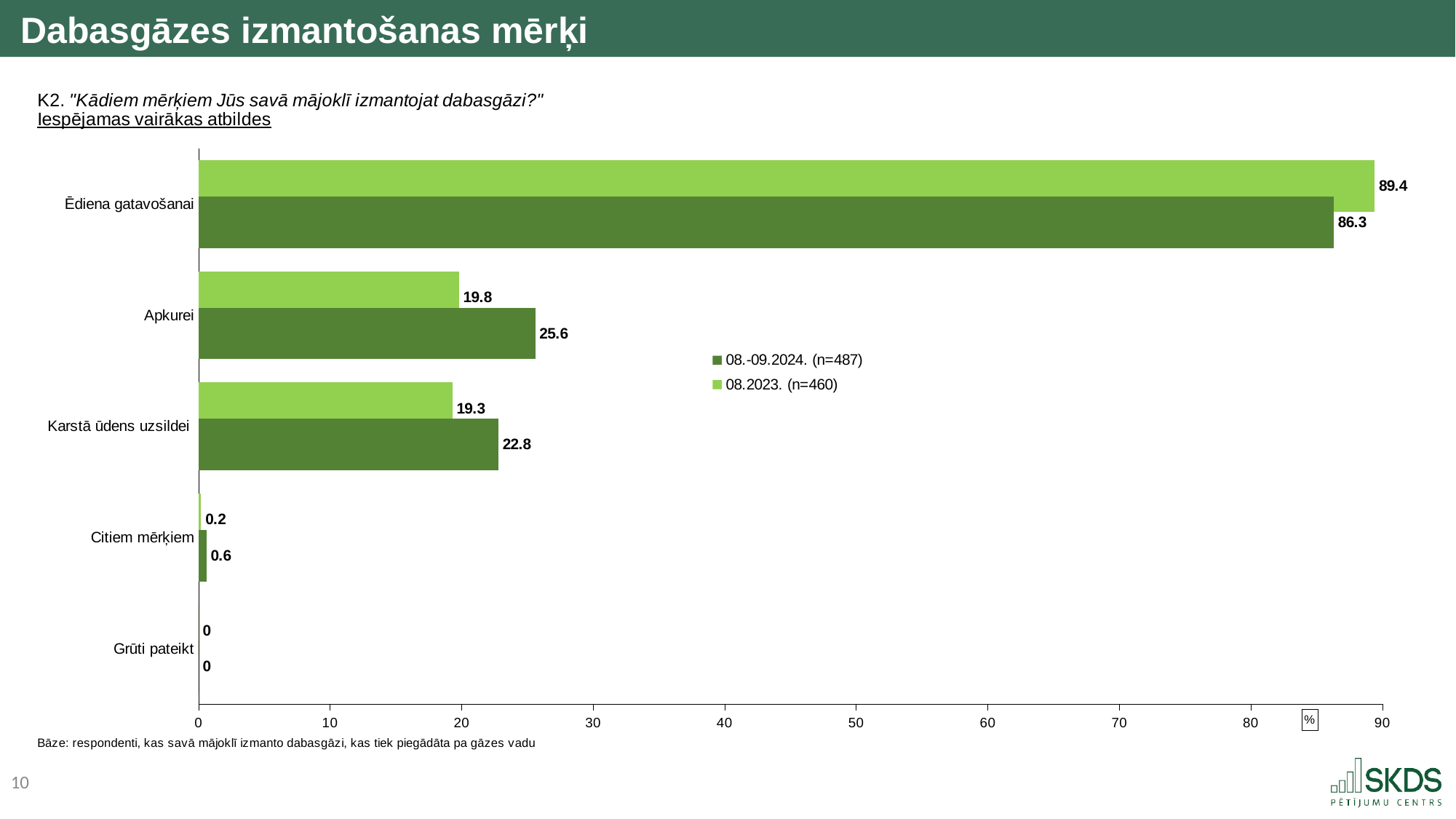
What is the value for Karstā ūdens uzsildei in the 08.-09.2024. (n=487) series? 22.8 How many categories are shown on the chart? 5 How many series does the legend list? 2 What is the difference between the 08.-09.2024. and 08.2023. values for Apkurei? 5.8 What is the value for Grūti pateikt in the 08.-09.2024. (n=487) series? 0 What is the value for Apkurei in the 08.2023. (n=460) series? 19.8 What kind of chart is shown on the slide? Bar chart What is the difference between the 08.2023. and 08.-09.2024. values for Ēdiena gatavošanai? 3.1 Which is larger for Karstā ūdens uzsildei: the 08.-09.2024. value or the 08.2023. value? 08.-09.2024. What is the value for Citiem mērķiem in the 08.2023. (n=460) series? 0.2 Which category has the highest value in the 08.2023. (n=460) series? Ēdiena gatavošanai What is the value for Ēdiena gatavošanai in the 08.-09.2024. (n=487) series? 86.3